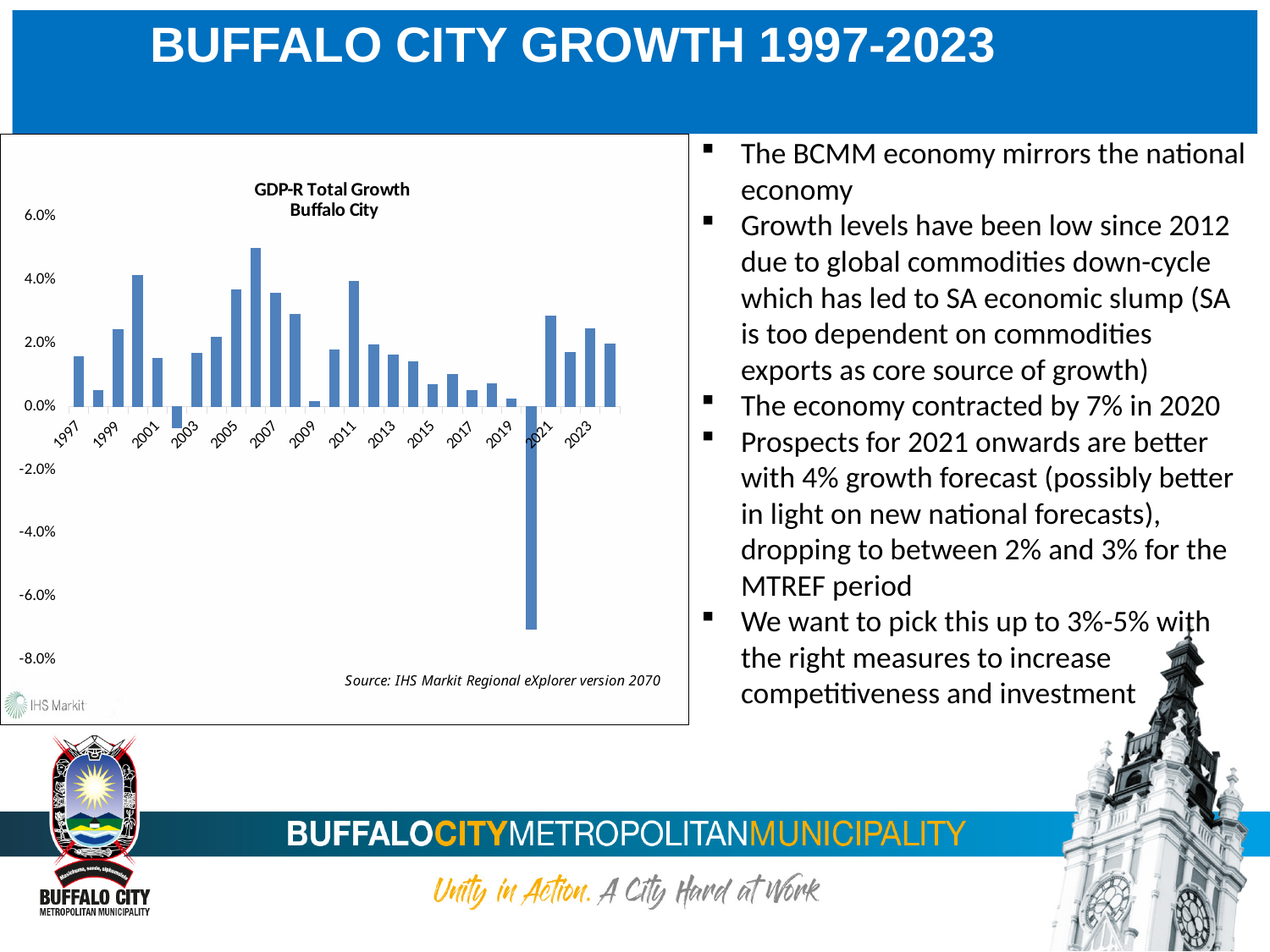
What source is cited for the chart? IHS Markit Regional eXplorer version 2070 What is the title of the chart? GDP-R Total Growth Buffalo City Which year has the larger growth value, 2006 or 2000? 2006 Is the value for 1998 greater or less than 2.0%? less Is the value for 2006 greater or less than 4.0%? greater Which year has the lowest GDP-R total growth in the chart? 2020 Is the value for 2005 greater or less than 4.0%? less Which year has the highest GDP-R total growth in the chart? 2006 What kind of chart is shown on the slide? Bar chart Which year has the larger growth value, 2002 or 2020? 2002 Do the growth values generally rise or fall from 2011 to 2019? Fall